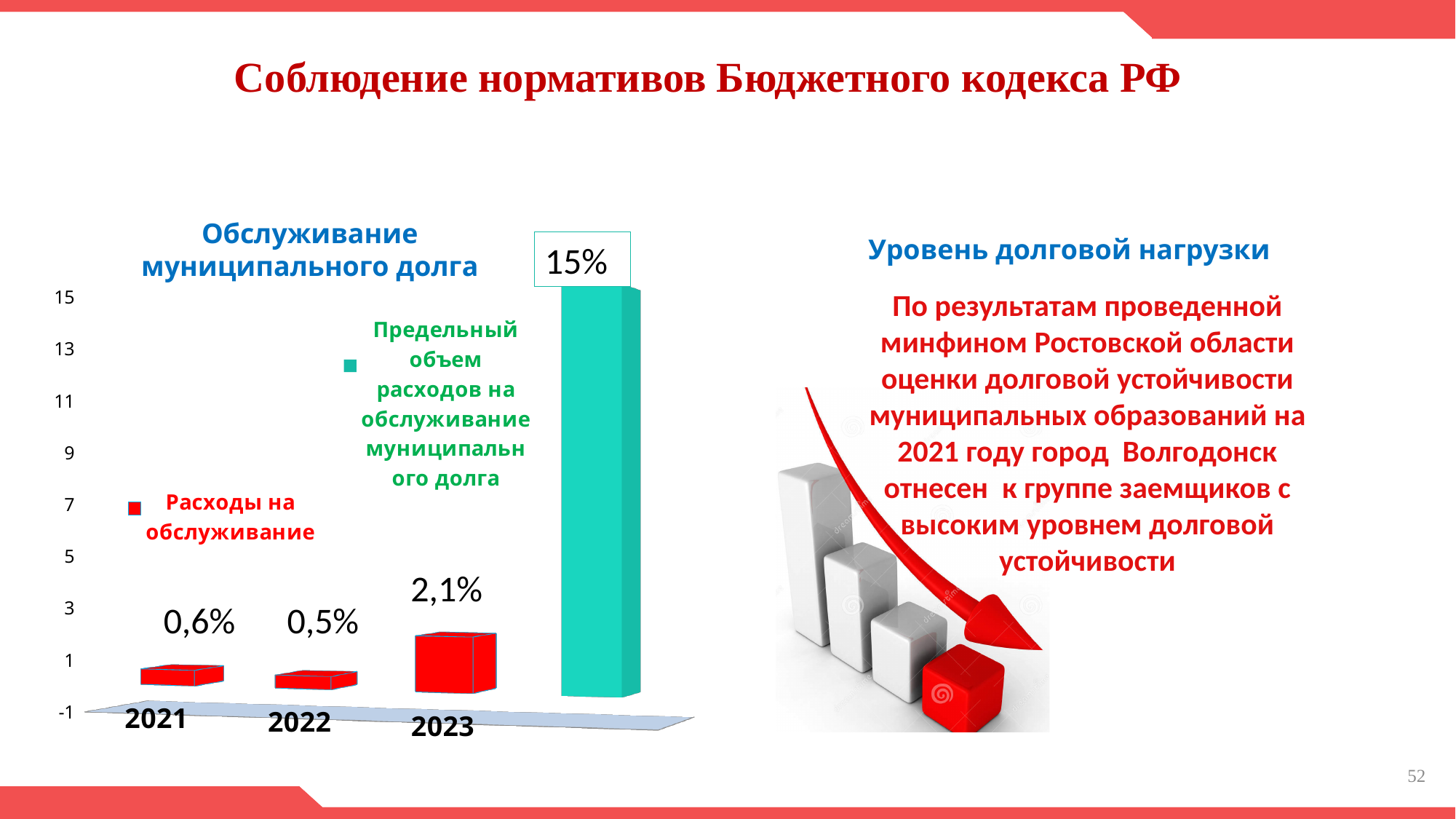
What is the value of the red bar for 2021 in the chart "Обслуживание муниципального долга"? 0,6% Which is larger in the chart: the value for 2021 or the value for 2022? 2021 Which year has the lowest value for "Расходы на обслуживание" in the chart? 2022 What is the value of the red bar for 2023 in the chart "Обслуживание муниципального долга"? 2,1% What colour are the bars for the series "Расходы на обслуживание"? Red Which year has the highest value for "Расходы на обслуживание" in the chart? 2023 How many series does the legend of the chart "Обслуживание муниципального долга" list? 2 What is the value of the red bar for 2022 in the chart "Обслуживание муниципального долга"? 0,5% What is the difference between the 2023 and 2022 values for "Расходы на обслуживание"? 1,6% What value is shown for the teal bar "Предельный объем расходов на обслуживание муниципального долга"? 15% How many years are shown on the x axis of the chart "Обслуживание муниципального долга"? 3 What type of chart is "Обслуживание муниципального долга"? Bar chart